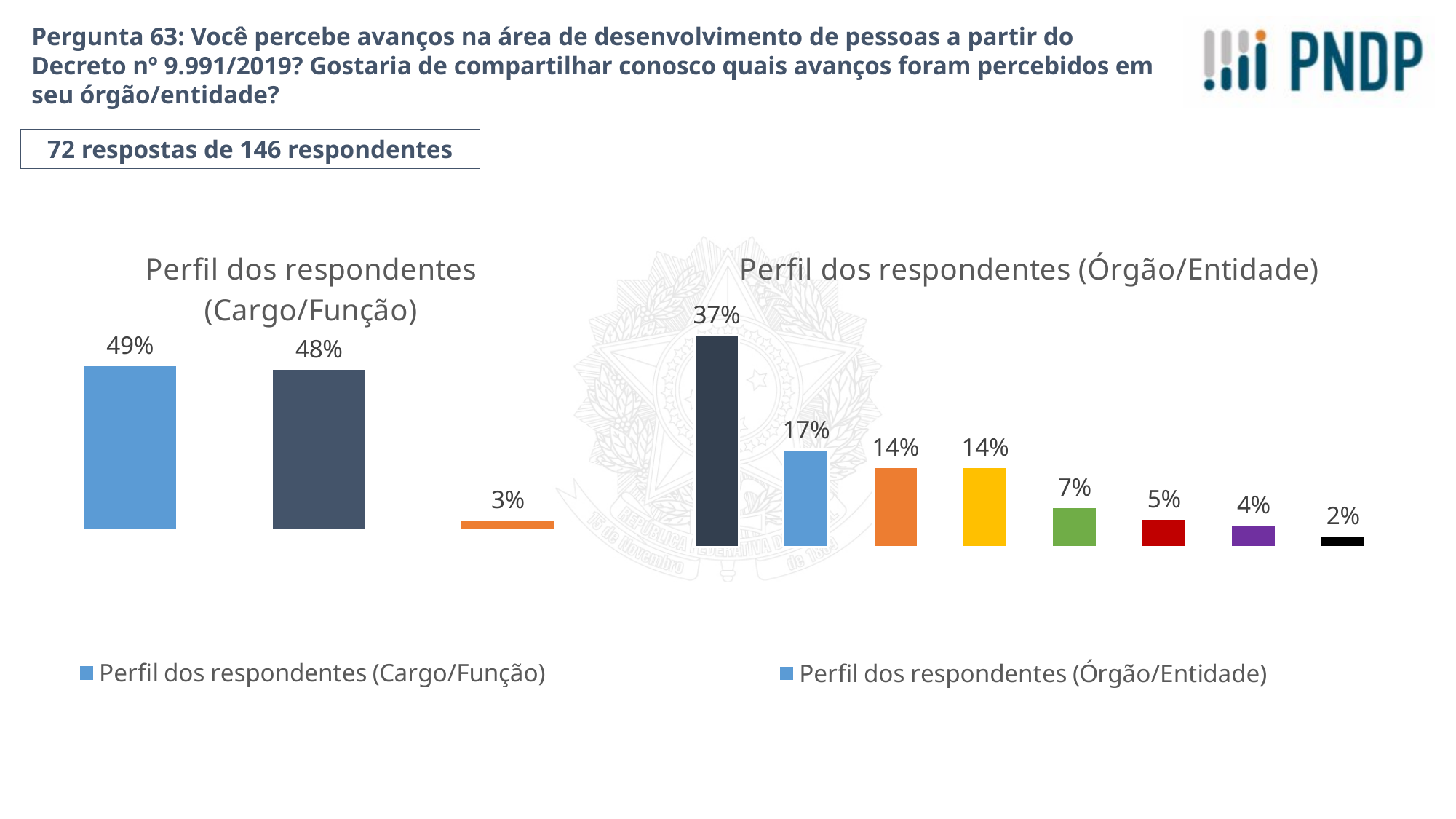
In the 'Perfil dos respondentes (Órgão/Entidade)' chart, what is the highest value shown? 37% Do the values in the 'Perfil dos respondentes (Órgão/Entidade)' chart rise or fall from left to right? fall How many bars are plotted in the 'Perfil dos respondentes (Cargo/Função)' chart? 3 In the 'Perfil dos respondentes (Órgão/Entidade)' chart, what is the difference between the tallest bar (37%) and the second tallest bar (17%)? 20% In the 'Perfil dos respondentes (Cargo/Função)' chart, what is the lowest value shown? 3% In the 'Perfil dos respondentes (Órgão/Entidade)' chart, which is larger: the green bar or the red bar? the green bar (7%) How many bars are plotted in the 'Perfil dos respondentes (Órgão/Entidade)' chart? 8 In the 'Perfil dos respondentes (Cargo/Função)' chart, what is the highest value shown? 49% In the 'Perfil dos respondentes (Cargo/Função)' chart, what value does the orange bar show? 3% In the 'Perfil dos respondentes (Órgão/Entidade)' chart, what is the lowest value shown? 2% What type of chart is the 'Perfil dos respondentes (Cargo/Função)' chart on the left? bar chart In the 'Perfil dos respondentes (Cargo/Função)' chart, what is the difference between the first bar (49%) and the second bar (48%)? 1%